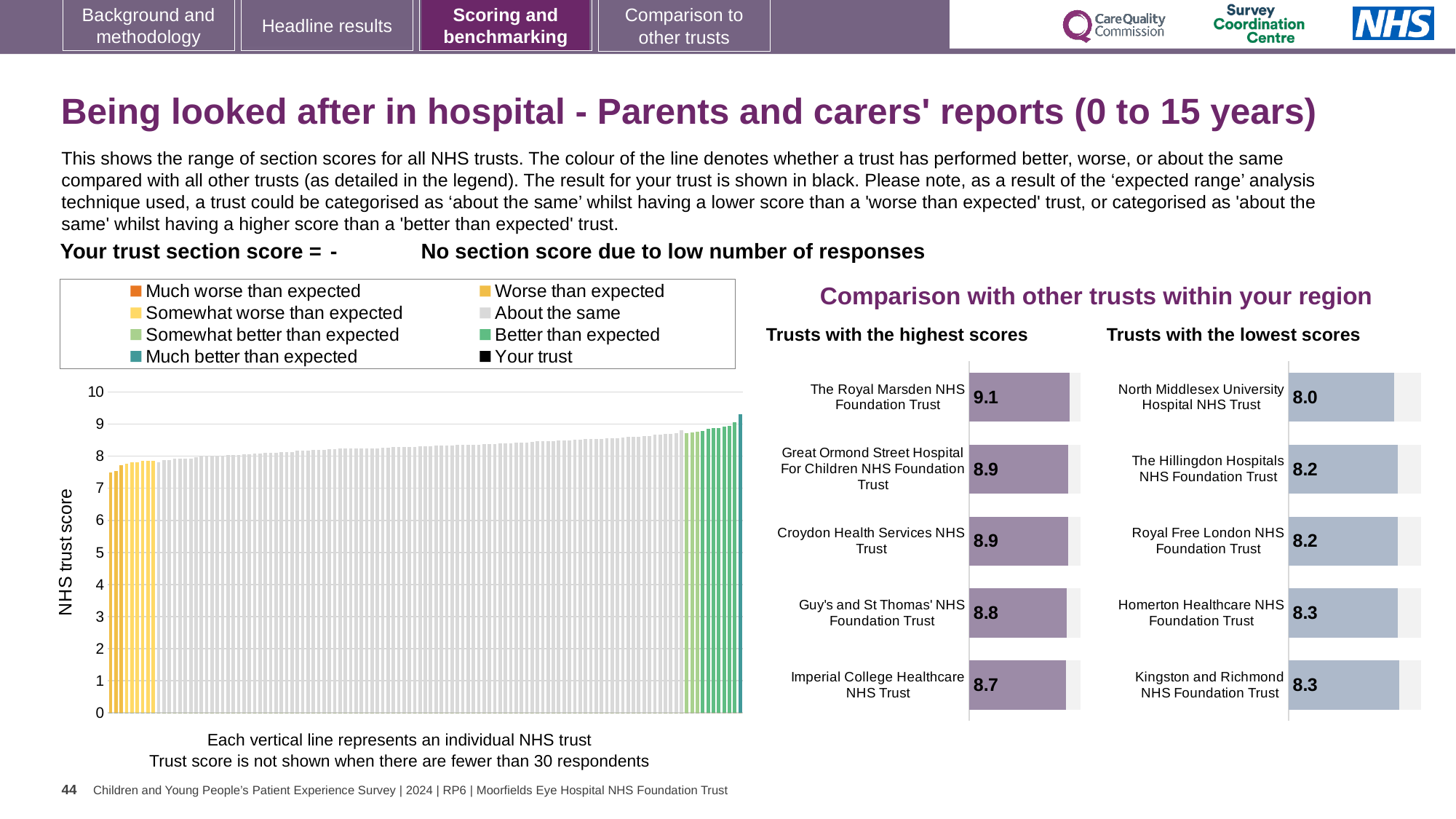
In the 'Trusts with the highest scores' chart, what is the difference between the scores of The Royal Marsden NHS Foundation Trust and Imperial College Healthcare NHS Trust? 0.4 In the 'Trusts with the lowest scores' chart, what is the score for North Middlesex University Hospital NHS Trust? 8.0 In the main chart on the left showing all NHS trusts, do the bar values rise or fall from left to right? rise In the 'Trusts with the lowest scores' chart, which has the higher score: The Hillingdon Hospitals NHS Foundation Trust or Kingston and Richmond NHS Foundation Trust? Kingston and Richmond NHS Foundation Trust In the 'Trusts with the highest scores' chart, which trust has the lowest score shown? Imperial College Healthcare NHS Trust In the 'Trusts with the highest scores' chart, what is the score for The Royal Marsden NHS Foundation Trust? 9.1 In the main chart on the left showing all NHS trusts, is the value of the leftmost bar greater or less than 8? less How many entries does the legend above the main chart on the left list? 8 In the 'Trusts with the lowest scores' chart, which trust has the lowest score? North Middlesex University Hospital NHS Trust In the 'Trusts with the lowest scores' chart, what is the difference between the scores of Homerton Healthcare NHS Foundation Trust and North Middlesex University Hospital NHS Trust? 0.3 How many trusts are listed in the 'Trusts with the highest scores' chart? 5 What is the y-axis label of the main chart on the left? NHS trust score